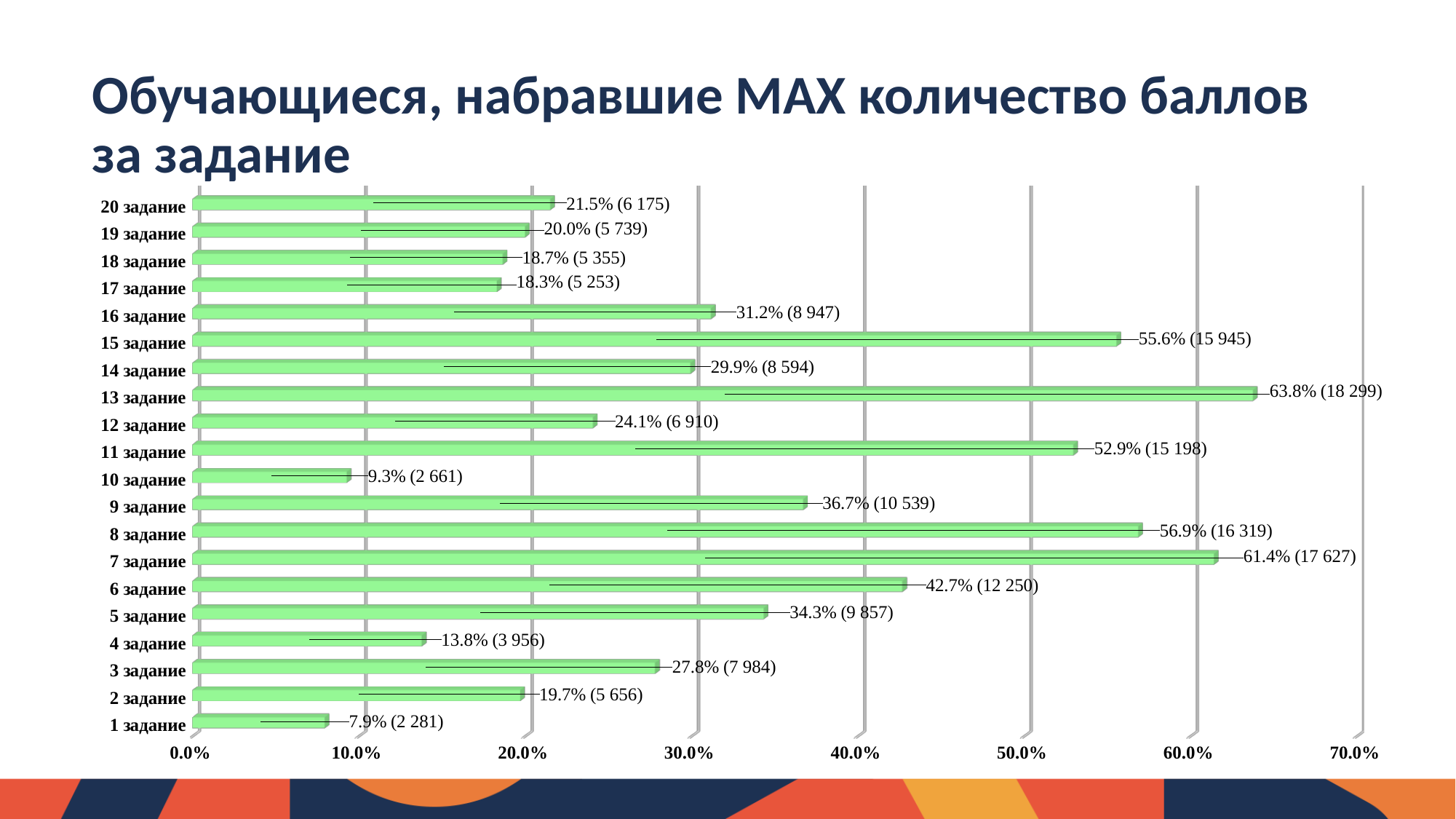
What is the data label shown for 13 задание? 63.8% (18 299) What is the title of the chart on the slide? Обучающиеся, набравшие MAX количество баллов за задание Which задание has the lowest percentage? 1 задание How many categories (задания) are plotted in the chart? 20 Is the value for 6 задание greater or less than 40.0%? greater What type of chart is shown on the slide? bar chart What percentage is shown for 10 задание? 9.3% Which задание has the highest percentage? 13 задание What is the difference in percentage points between 6 задание (42.7%) and 5 задание (34.3%)? 8.4 What number in parentheses is shown for 7 задание? 17 627 Which has a larger percentage, 9 задание or 12 задание? 9 задание Is the value for 4 задание greater or less than 20.0%? less